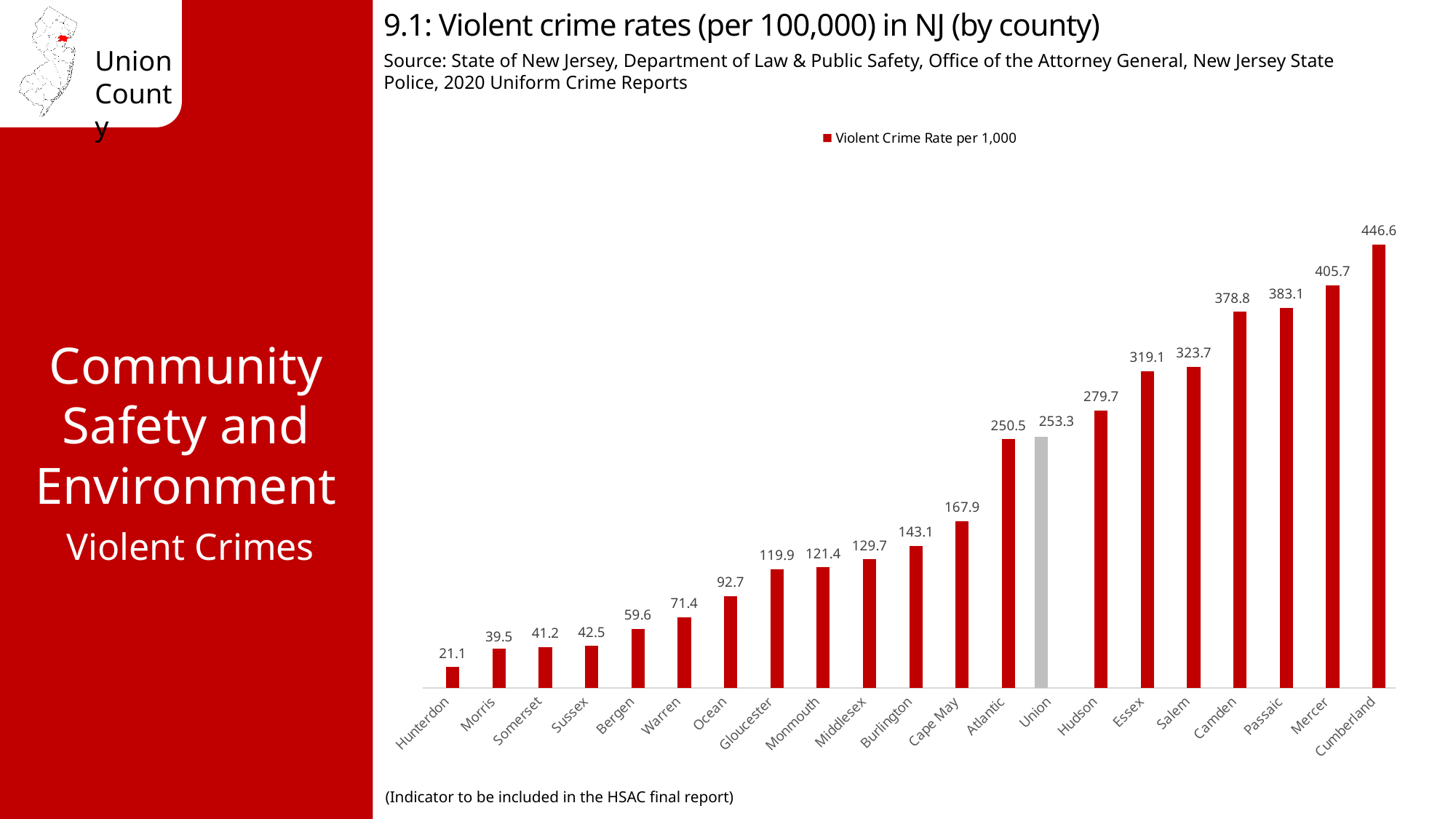
Which has a higher violent crime rate, Essex or Camden? Camden What kind of chart is shown on the slide? Bar chart Which county has the highest violent crime rate on the chart? Cumberland Do the values rise or fall from left to right along the x axis? Rise Which county has the lowest violent crime rate on the chart? Hunterdon How many series does the legend list? 1 How many counties are shown on the chart? 21 What is the violent crime rate shown for Hudson? 279.7 What is the violent crime rate shown for Cape May? 167.9 What is the violent crime rate shown for Union county? 253.3 What is the difference between the violent crime rates of Cumberland and Hunterdon? 425.5 What is the difference between the violent crime rates of Mercer and Hudson? 126.0